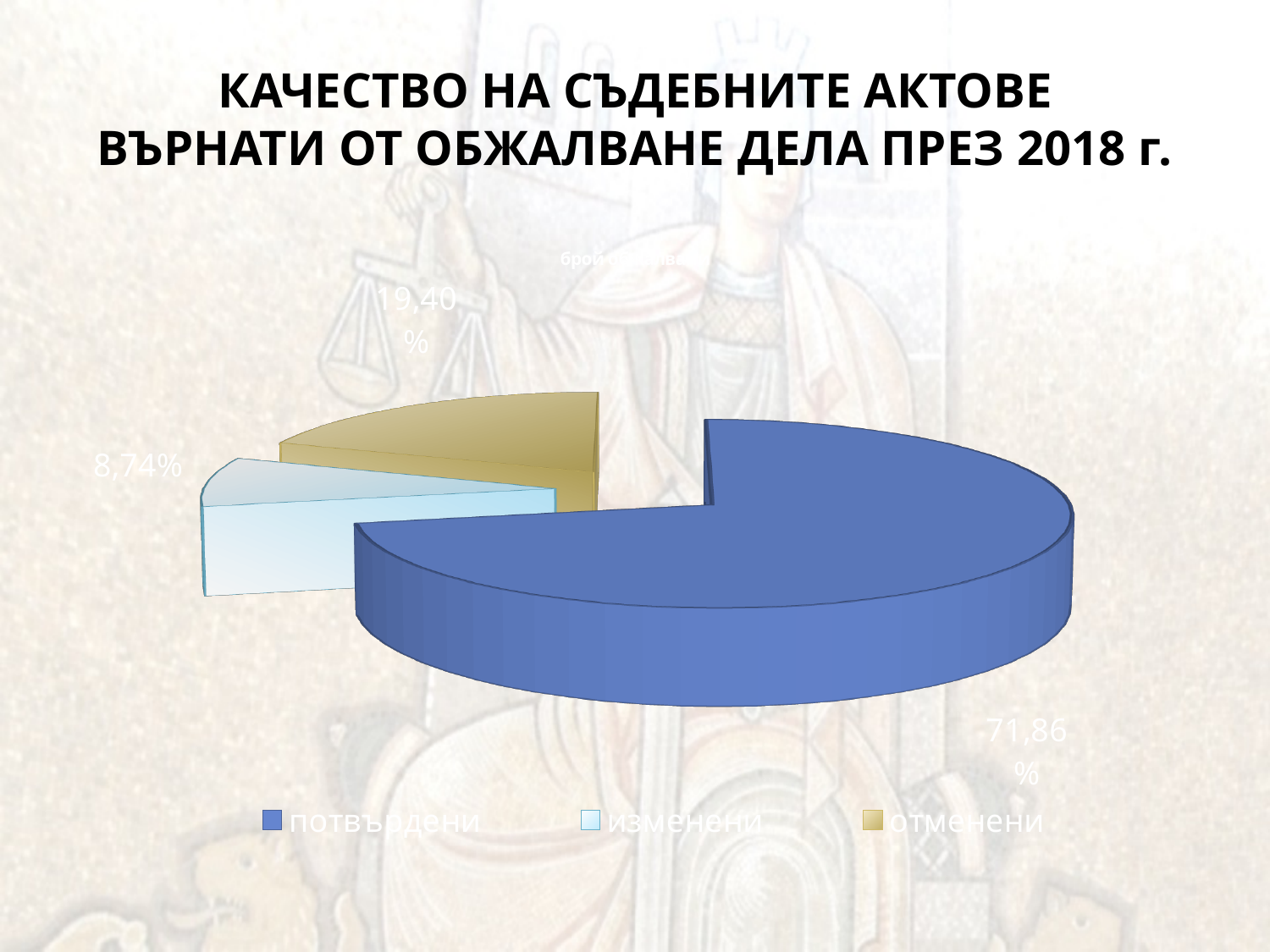
What share of the pie does the "отменени" slice represent? 19,40% What kind of chart is shown on the slide? pie chart How many slices does the pie chart have? 3 Which is larger, the share for "отменени" or the share for "изменени"? отменени Which category has the largest share of the pie? потвърдени What is the difference in percentage points between the "потвърдени" and "отменени" shares? 52,46 What share of the pie does the "потвърдени" slice represent? 71,86% Which category has the smallest share of the pie? изменени What colour is the "потвърдени" slice? blue What is the difference in percentage points between the "отменени" and "изменени" shares? 10,66 How many entries does the legend list? 3 What share of the pie does the "изменени" slice represent? 8,74%